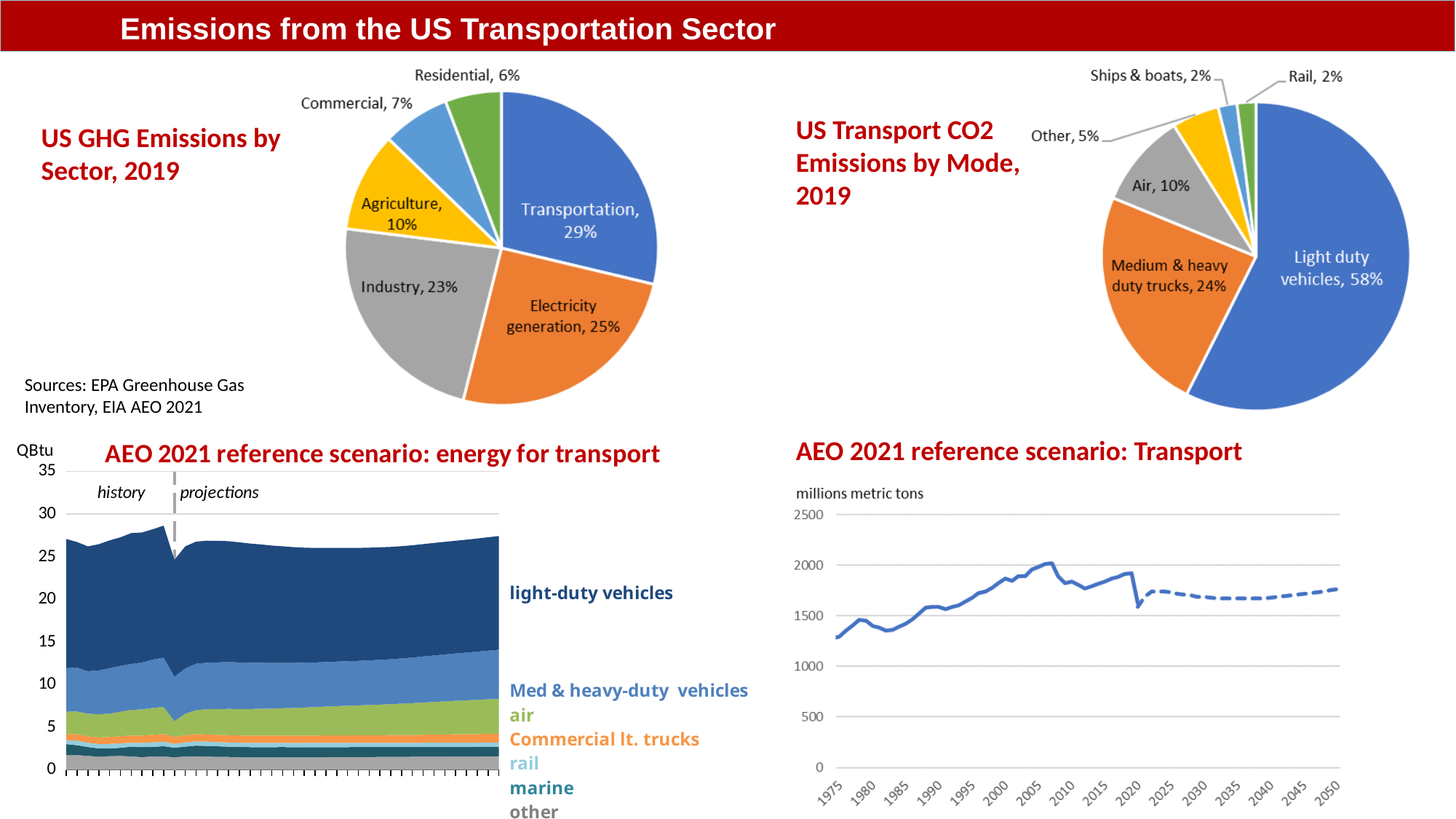
In the AEO 2021 reference scenario: Transport line chart, do emissions rise or fall between 1975 and 2005? rise In the US GHG Emissions by Sector, 2019 pie chart, what share is Transportation? 29% In the US Transport CO2 Emissions by Mode, 2019 pie chart, which is larger, Air or Other? Air In the US GHG Emissions by Sector, 2019 pie chart, how many sectors are shown? 6 How many series does the legend of the AEO 2021 reference scenario: energy for transport chart list? 7 In the US Transport CO2 Emissions by Mode, 2019 pie chart, what is the combined share of Ships & boats and Rail? 4% In the US Transport CO2 Emissions by Mode, 2019 pie chart, what share is Medium & heavy duty trucks? 24% In the US GHG Emissions by Sector, 2019 pie chart, what is the difference between the Transportation and Industry shares? 6% In the US Transport CO2 Emissions by Mode, 2019 pie chart, which mode has the largest share? Light duty vehicles What kind of chart is the AEO 2021 reference scenario: energy for transport chart? Stacked area chart In the US GHG Emissions by Sector, 2019 pie chart, which sector has the smallest share? Residential In the AEO 2021 reference scenario: Transport line chart, is the value for 2050 greater or less than 2000 million metric tons? less